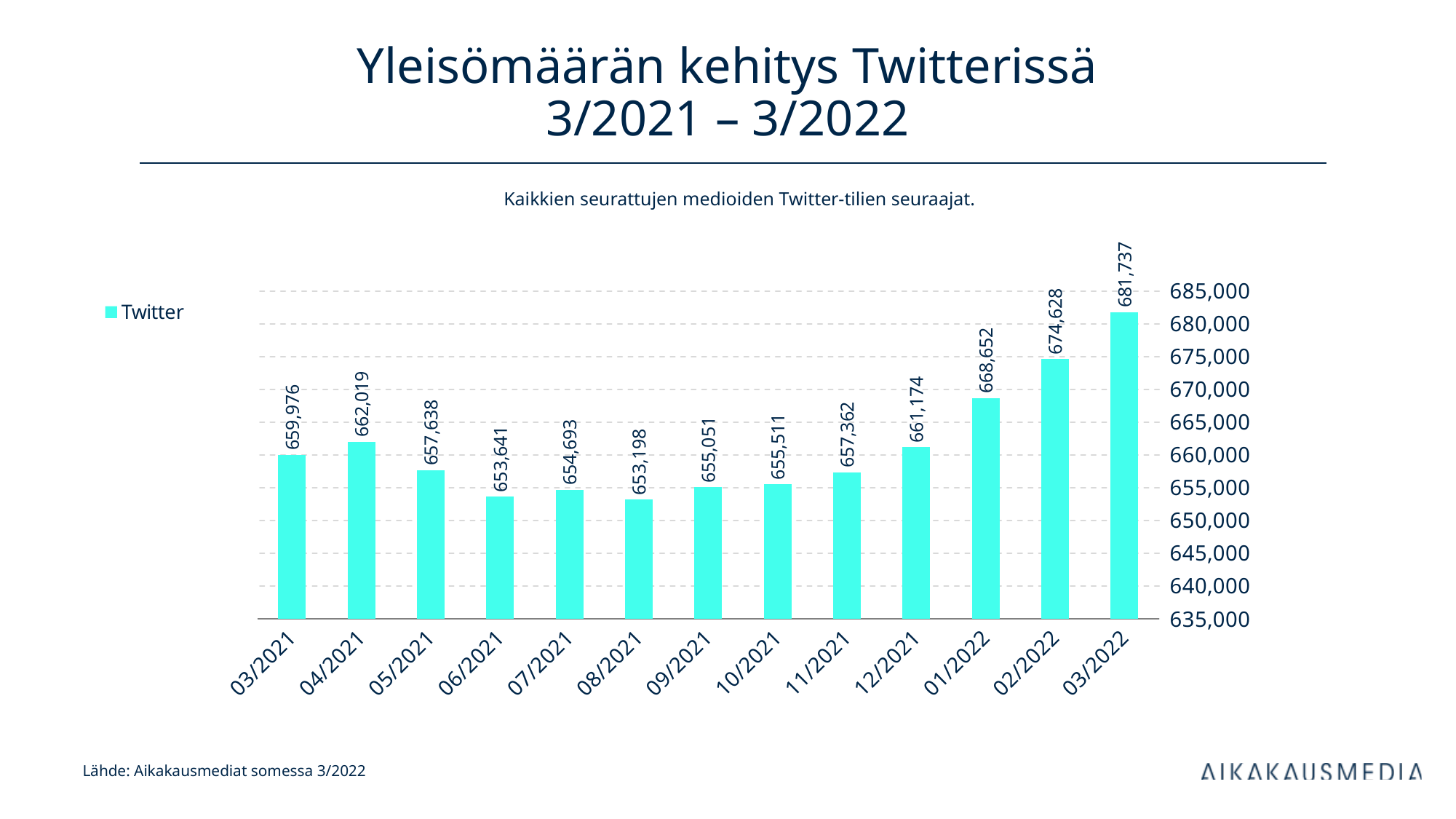
Which month has the lowest value? 08/2021 Which is larger, the value for 04/2021 or the value for 12/2021? 04/2021 What is the difference between the values for 03/2022 and 03/2021? 21,761 What is the Twitter follower count for 03/2021? 659,976 What is the value shown for 01/2022? 668,652 How many series does the legend list? 1 How many months are shown on the x axis? 13 Which month has the highest value? 03/2022 Is the value for 02/2022 greater or less than 670,000? greater What is the value shown for 10/2021? 655,511 What is the difference between the values for 02/2022 and 01/2022? 5,976 What kind of chart is shown on the slide? Bar chart